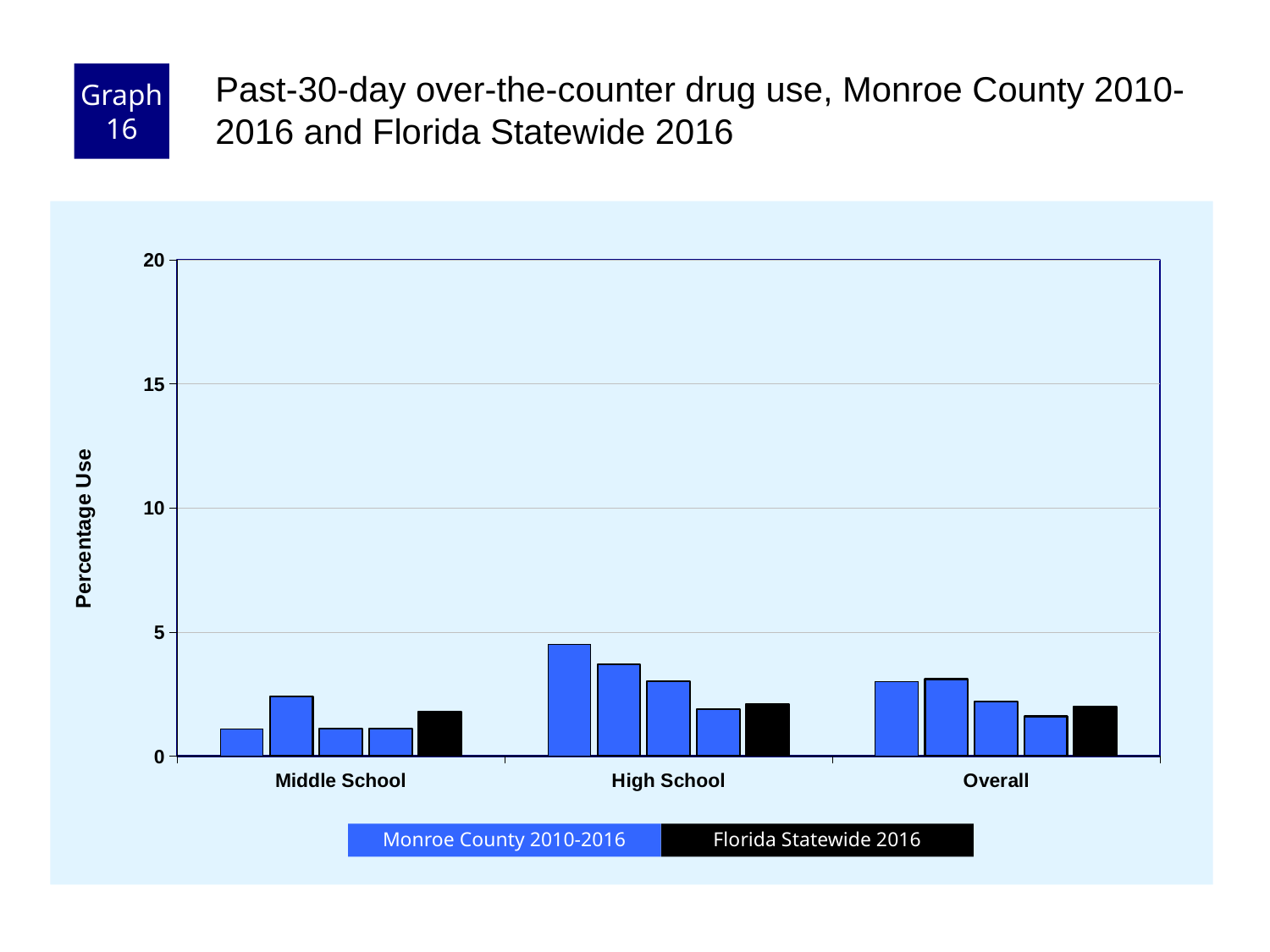
Is the Florida Statewide 2016 value for Overall greater or less than 10? less What is the label on the y axis of the chart? Percentage Use How many categories are shown on the x axis of the chart? 3 What kind of chart is shown on the slide? bar chart Which is larger: the tallest Monroe County 2010-2016 bar for High School or the tallest Monroe County 2010-2016 bar for Middle School? High School Is the Florida Statewide 2016 value for Middle School greater or less than 5? less Which category contains the tallest bar in the chart? High School How many series does the chart's legend list? 2 What is the highest value shown on the y axis of the chart? 20 Is the tallest bar in the High School group greater or less than 5? less What colour are the Florida Statewide 2016 bars in the chart? black Which is larger: the Florida Statewide 2016 bar for High School or the shortest Monroe County 2010-2016 bar for Middle School? Florida Statewide 2016 for High School